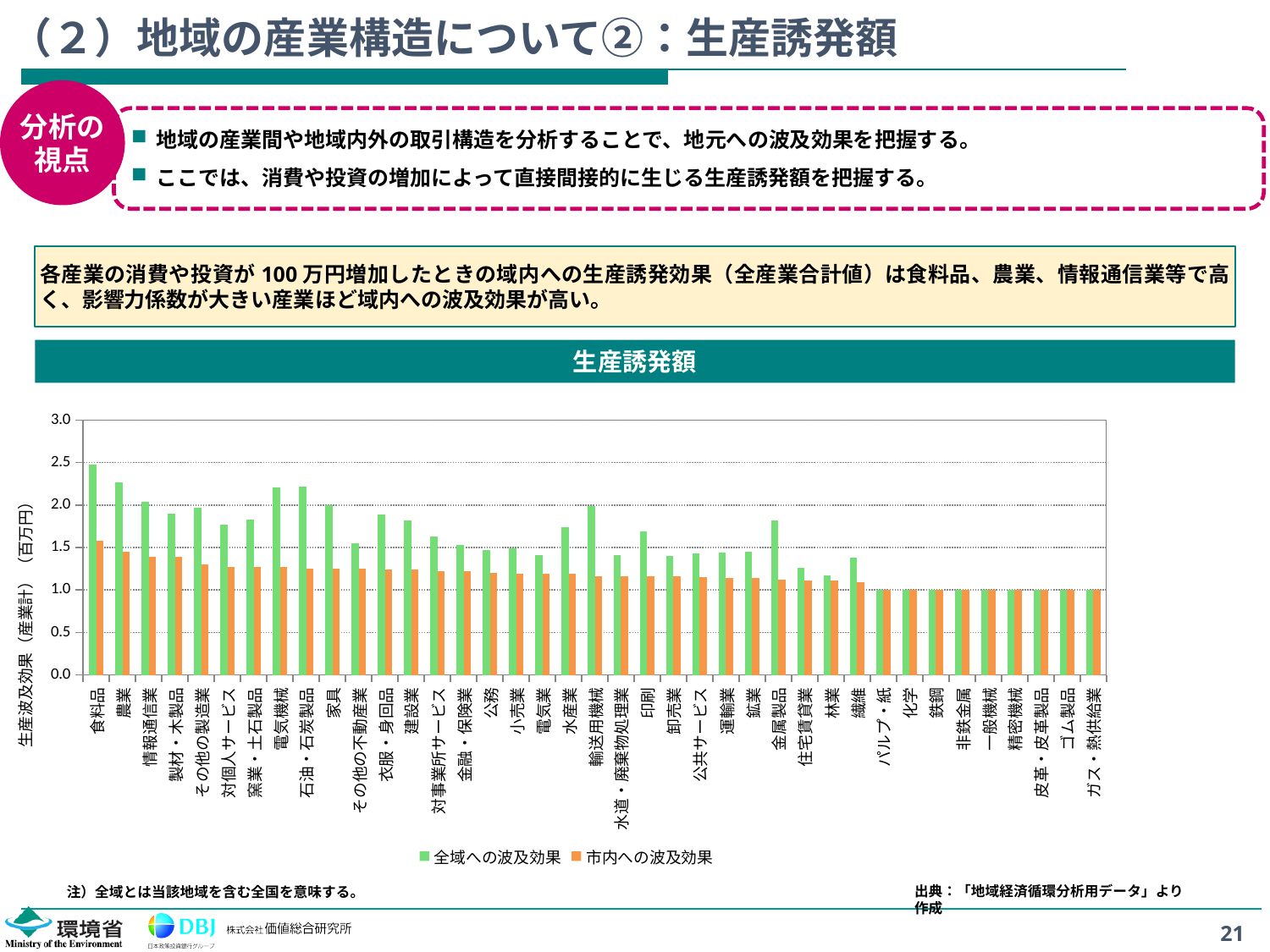
Which industry has the highest 全域への波及効果 value in the 生産誘発額 chart? 食料品 How many industry categories are plotted along the x axis of the 生産誘発額 chart? 39 Is the 全域への波及効果 value for 農業 greater or less than 2.0? greater Is the 全域への波及効果 value for 金属製品 greater or less than 1.5? greater Do the 全域への波及効果 values generally rise or fall moving from left to right along the x axis? fall What is the y-axis title of the 生産誘発額 chart? 生産波及効果（産業計）（百万円） How many series does the legend of the 生産誘発額 chart list? 2 Is the 全域への波及効果 value for 住宅賃貸業 greater or less than 1.5? less Which has the larger 全域への波及効果 value, 電気機械 or 家具? 電気機械 Which industry has the highest 市内への波及効果 value in the 生産誘発額 chart? 食料品 What kind of chart is shown under the heading 生産誘発額? bar chart